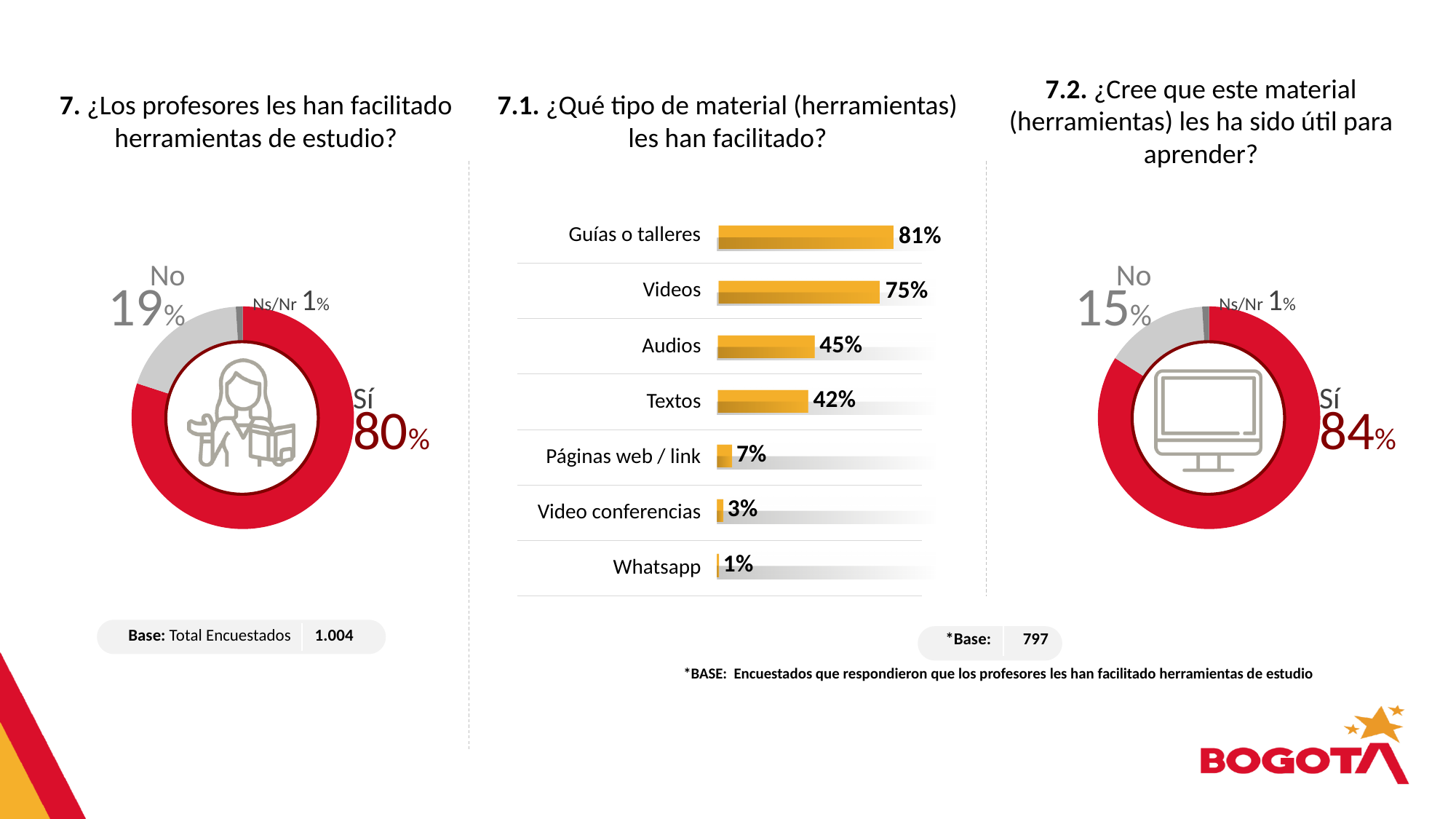
In the bar chart '7.1. ¿Qué tipo de material (herramientas) les han facilitado?', what is the difference between Audios and Textos? 3% What kind of chart is used for '7. ¿Los profesores les han facilitado herramientas de estudio?'? Doughnut chart In the bar chart '7.1. ¿Qué tipo de material (herramientas) les han facilitado?', which category has the highest value? Guías o talleres In the bar chart '7.1. ¿Qué tipo de material (herramientas) les han facilitado?', which category has the lowest value? Whatsapp In the bar chart '7.1. ¿Qué tipo de material (herramientas) les han facilitado?', what is the value for Videos? 75% In the right chart '7.2. ¿Cree que este material (herramientas) les ha sido útil para aprender?', what is the value for Ns/Nr? 1% In the left chart '7. ¿Los profesores les han facilitado herramientas de estudio?', what is the share for Sí? 80% In the bar chart '7.1. ¿Qué tipo de material (herramientas) les han facilitado?', which is larger, Páginas web / link or Video conferencias? Páginas web / link In the left chart '7. ¿Los profesores les han facilitado herramientas de estudio?', what is the value for No? 19% In the right chart '7.2. ¿Cree que este material (herramientas) les ha sido útil para aprender?', what is the share for Sí? 84% How many categories are shown in the bar chart '7.1. ¿Qué tipo de material (herramientas) les han facilitado?'? 7 What kind of chart is used for '7.1. ¿Qué tipo de material (herramientas) les han facilitado?'? Bar chart